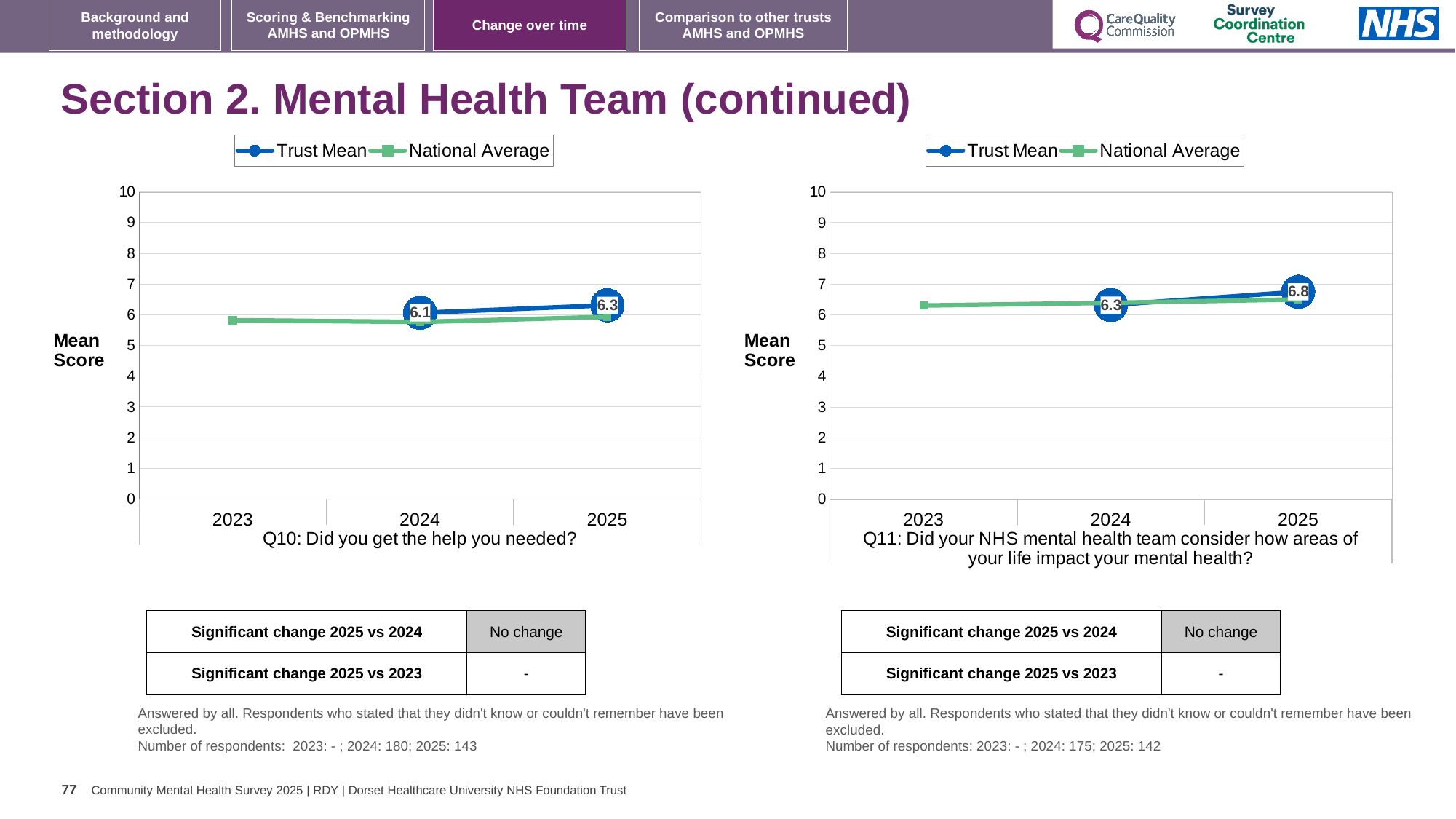
In the Q10 chart (left), by how much did the Trust Mean change from 2024 to 2025? 0.2 In the Q10 chart (left), is the National Average value for 2023 greater or less than 7? less In the Q11 chart (right), by how much did the Trust Mean change from 2024 to 2025? 0.5 In the Q11 chart (right), what is the Trust Mean value for 2024? 6.3 In the Q11 chart (right), which is larger in 2025: the Trust Mean or the National Average? Trust Mean How many series does the legend of the Q10 chart (left) list? 2 In the Q10 chart (left), what is the Trust Mean value for 2025? 6.3 In the Q10 chart (left), does the Trust Mean rise or fall from 2024 to 2025? rise In the Q10 chart (left), what is the Trust Mean value for 2024? 6.1 In the Q11 chart (right), what is the Trust Mean value for 2025? 6.8 How many years are shown on the x axis of the Q11 chart (right)? 3 What kind of chart is the Q11 chart (right)? line chart